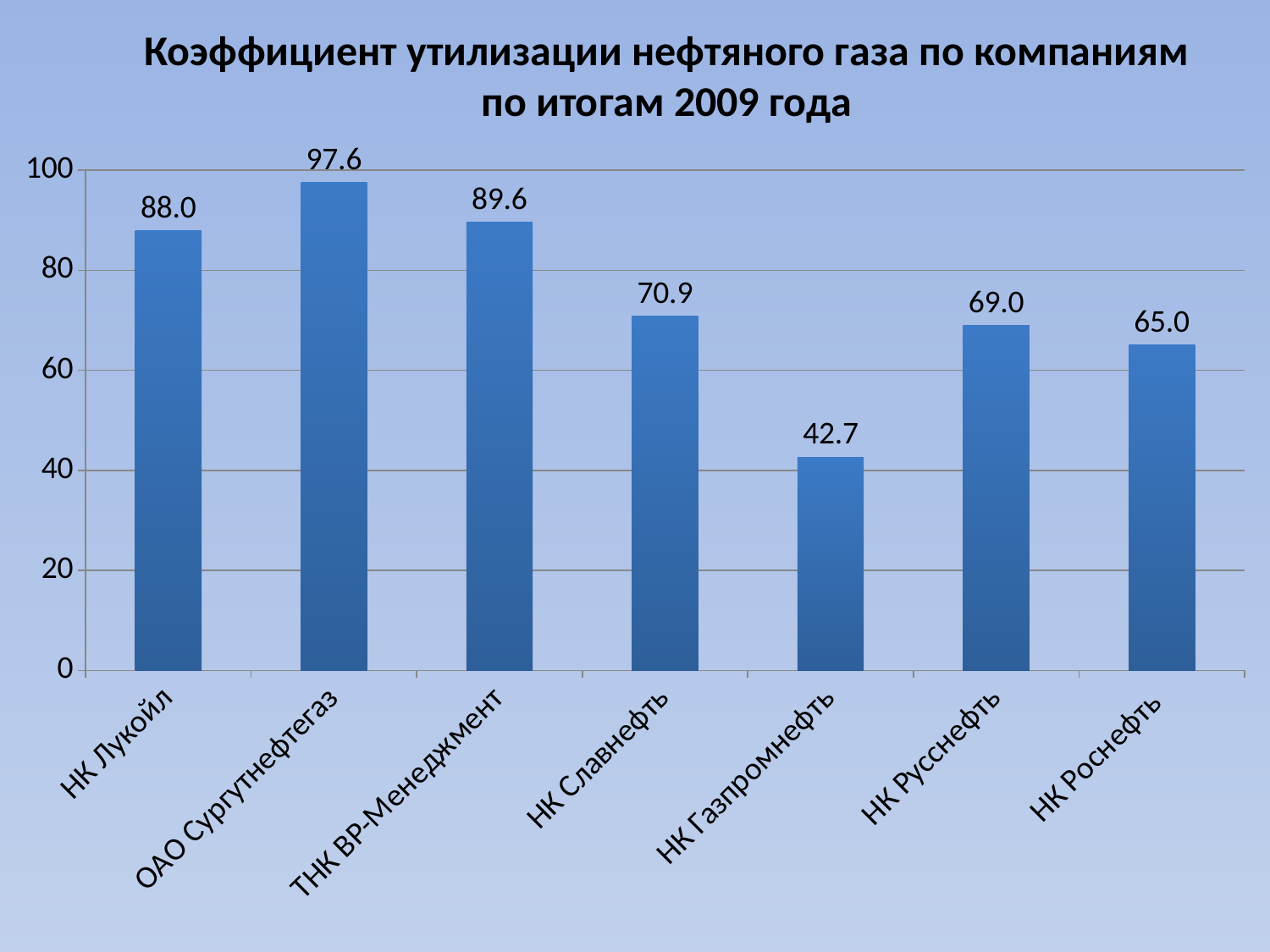
Which company has the highest value? ОАО Сургутнефтегаз What is the value for НК Лукойл? 88.0 What is the value for НК Газпромнефть? 42.7 Is the value for НК Русснефть greater or less than 60? greater Which is larger, the value for ТНК ВР-Менеджмент or the value for НК Лукойл? ТНК ВР-Менеджмент What is the difference between the values for ОАО Сургутнефтегаз and НК Газпромнефть? 54.9 How many companies are shown in the chart? 7 What is the difference between the values for НК Славнефть and НК Русснефть? 1.9 Which company has the lowest value? НК Газпромнефть What kind of chart is shown on the slide? bar chart What is the value for НК Роснефть? 65.0 What is the title of the chart? Коэффициент утилизации нефтяного газа по компаниям по итогам 2009 года